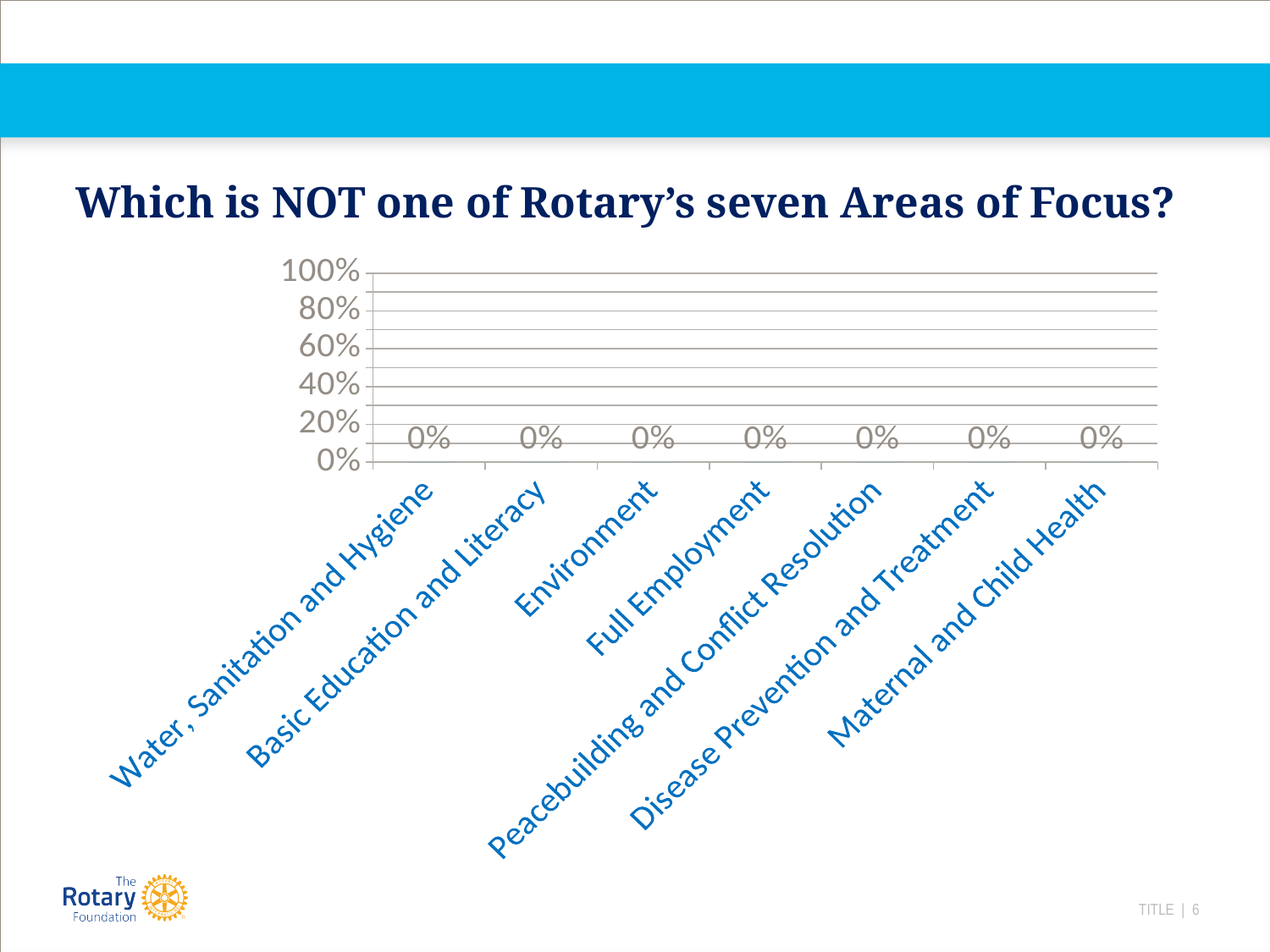
What is the difference between the values for Basic Education and Literacy and Disease Prevention and Treatment? 0% What is the title of the slide above the chart? Which is NOT one of Rotary's seven Areas of Focus? What is the value for Maternal and Child Health? 0% Is the value for Disease Prevention and Treatment greater or less than 20%? less What is the value for Full Employment? 0% Do the values rise, fall, or stay flat across the categories? stay flat What is the value for Environment? 0% What is the value for Water, Sanitation and Hygiene? 0% What is the value for Peacebuilding and Conflict Resolution? 0% How many categories are shown on the x axis? 7 What is the highest value shown on the y axis? 100% What kind of chart is shown on the slide? bar chart